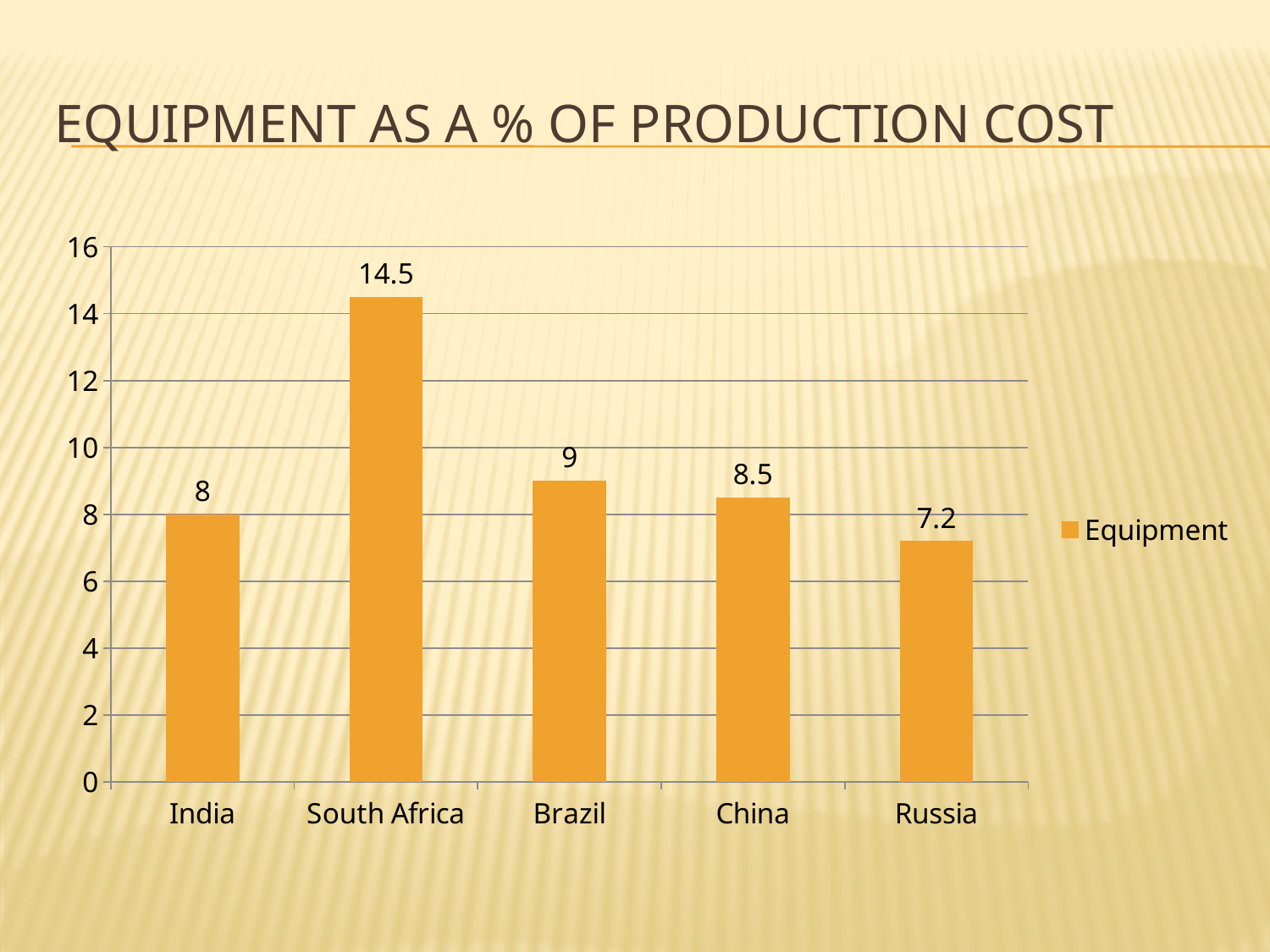
What is the value for South Africa? 14.5 Which is larger, the value for Brazil or the value for China? Brazil Which country has the lowest value? Russia What is the value for China? 8.5 What series name does the legend list? Equipment What kind of chart is shown? bar chart Which country has the highest value? South Africa What is the difference between the values for Brazil and Russia? 1.8 How many countries are shown on the x axis? 5 What is the difference between the values for South Africa and India? 6.5 What is the value for Russia? 7.2 Is the value for South Africa greater or less than 12? greater